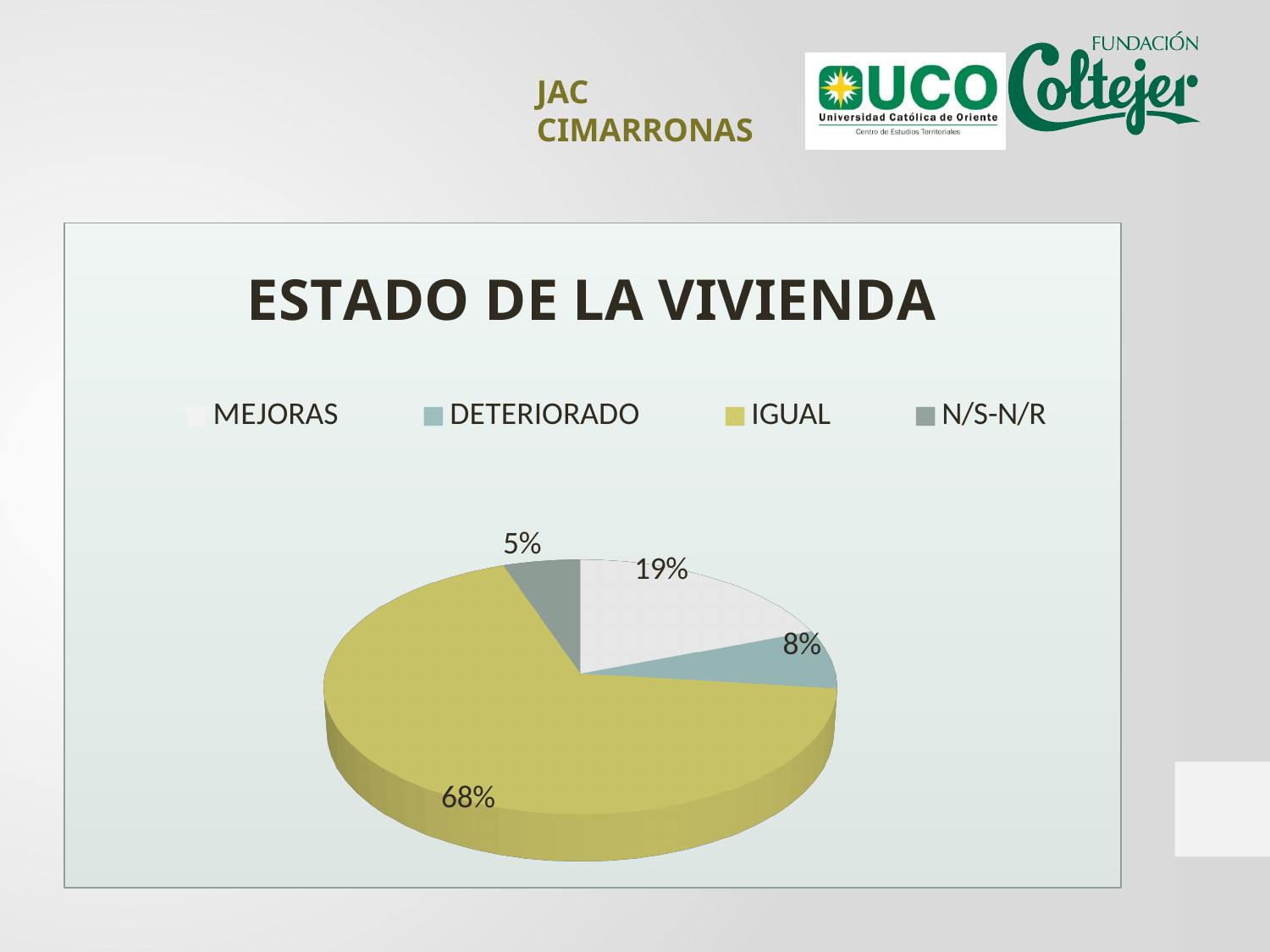
Which is larger, the share for MEJORAS or the share for DETERIORADO? MEJORAS What is the combined share of DETERIORADO and N/S-N/R? 13% What type of chart is shown on the slide? Pie chart What percentage of the pie does DETERIORADO represent? 8% Which category has the largest share of the pie? IGUAL What is the title of the chart? ESTADO DE LA VIVIENDA How many categories does the legend list? 4 What percentage of the pie does MEJORAS represent? 19% What percentage of the pie does IGUAL represent? 68% Which category has the smallest share of the pie? N/S-N/R What is the difference in percentage points between IGUAL and MEJORAS? 49 What percentage of the pie does N/S-N/R represent? 5%